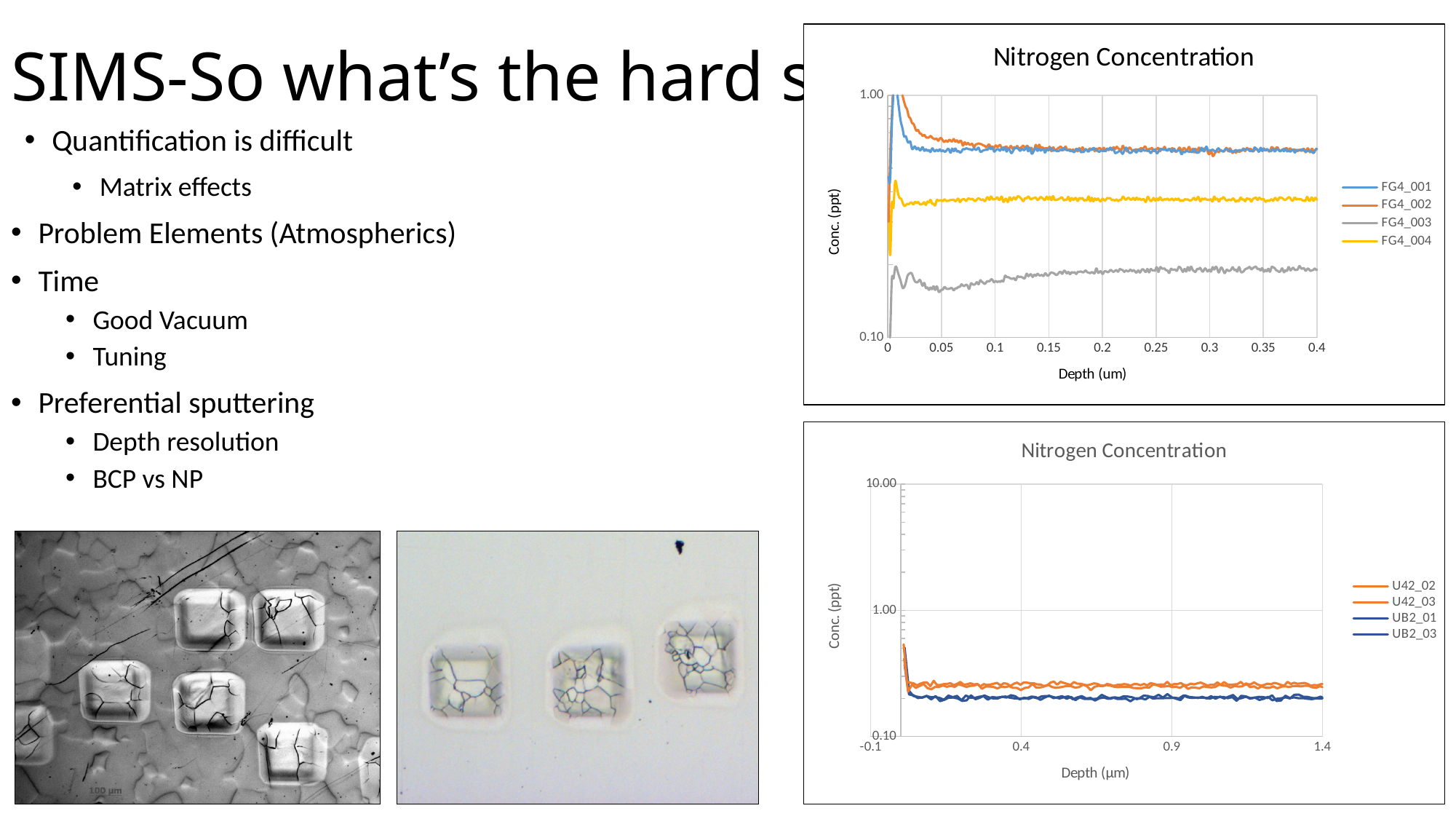
How many series does the legend of the bottom Nitrogen Concentration chart list? 4 In the top Nitrogen Concentration chart, which series has the lowest concentration across the depth range? FG4_003 In the bottom Nitrogen Concentration chart, is the value of UB2_03 at a depth of 0.9 um greater or less than 1.00? less In the bottom Nitrogen Concentration chart, which series is higher, U42_02 or UB2_01? U42_02 What is the y-axis label of the bottom Nitrogen Concentration chart? Conc. (ppt) In the top Nitrogen Concentration chart, does the FG4_003 series rise or fall between depths of 0.05 and 0.4 um? rise How many series does the legend of the top Nitrogen Concentration chart list? 4 What kind of chart is the top chart titled Nitrogen Concentration? line chart What is the x-axis label of the top Nitrogen Concentration chart? Depth (um) In the top Nitrogen Concentration chart, which series is higher, FG4_004 or FG4_003? FG4_004 In the top Nitrogen Concentration chart, is the value of FG4_003 at a depth of 0.4 um greater or less than 1.00? less